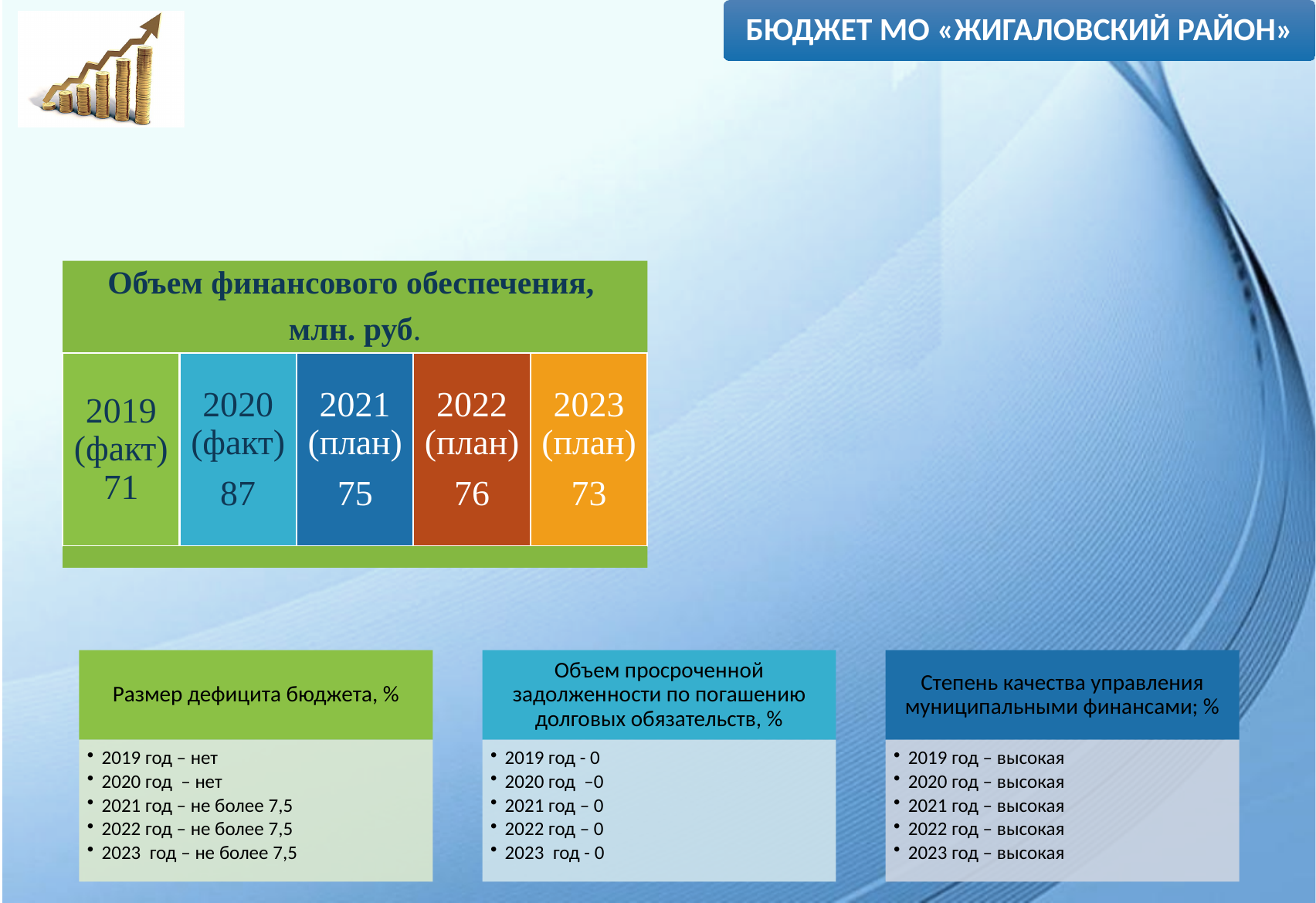
In the block "Объем финансового обеспечения, млн. руб.", what is the value for 2020 (факт)? 87 In the block "Объем финансового обеспечения, млн. руб.", what is the difference between the 2020 value and the 2019 value? 16 In the block "Объем финансового обеспечения, млн. руб.", which year has the highest value? 2020 (факт) How many years are shown in the block "Объем финансового обеспечения, млн. руб."? 5 In the block "Объем финансового обеспечения, млн. руб.", how many years are marked as факт (actual)? 2 In the block "Объем финансового обеспечения, млн. руб.", what is the difference between the 2022 plan and the 2023 plan? 3 In the block "Объем финансового обеспечения, млн. руб.", which year has the lowest value? 2019 (факт) In the block "Объем финансового обеспечения, млн. руб.", what colour is the 2022 (план) box? Orange-brown (dark orange) In the block "Объем финансового обеспечения, млн. руб.", what is the planned value for 2023? 73 What unit is stated in the title of the block "Объем финансового обеспечения"? млн. руб. In the block "Объем финансового обеспечения, млн. руб.", what is the value for 2019 (факт)? 71 In the block "Объем финансового обеспечения, млн. руб.", which is larger: the 2021 plan or the 2022 plan? 2022 (план)